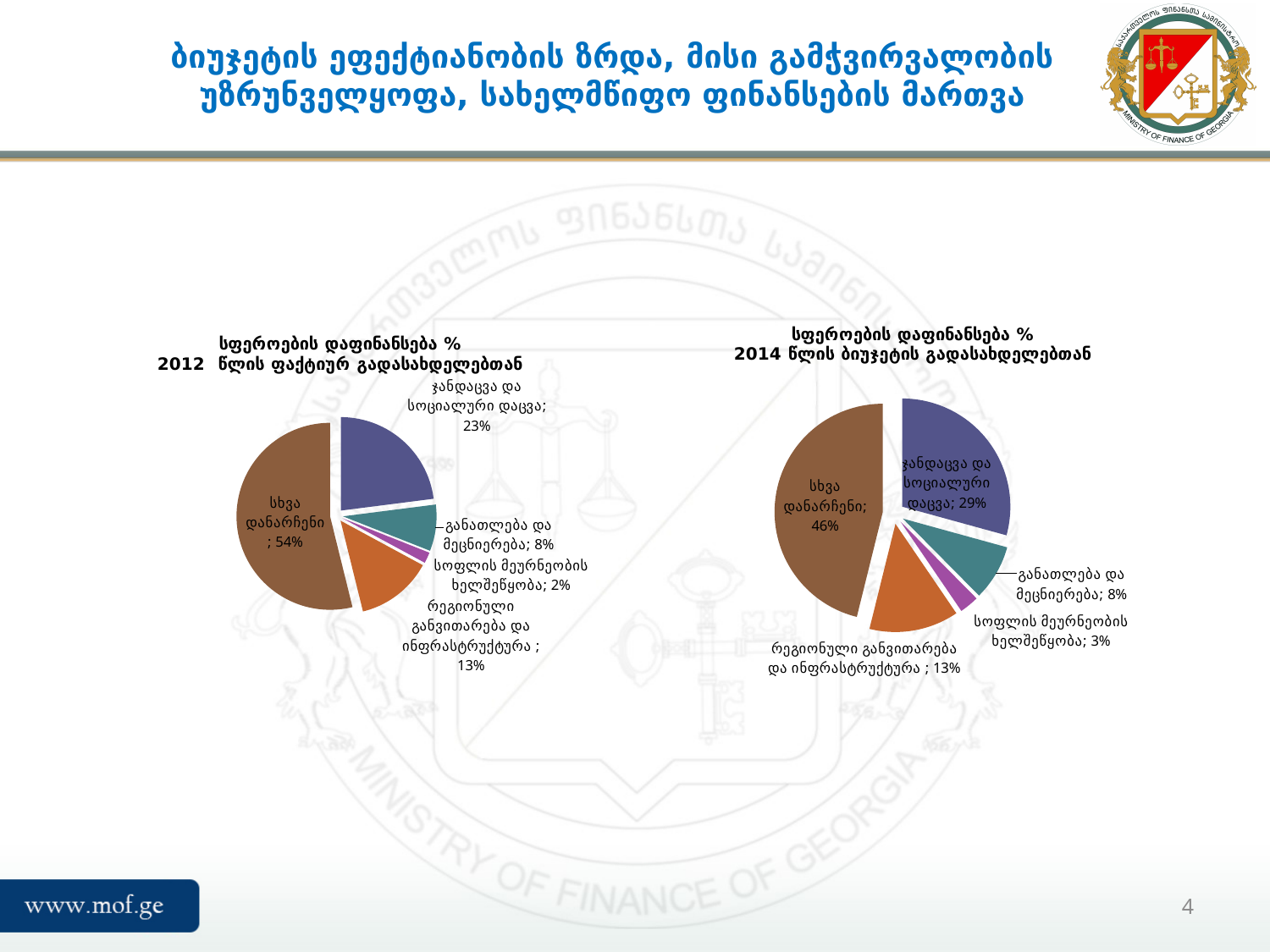
In the left chart (2012), which category has the largest slice? სხვა დანარჩენი What is the difference between the share for სხვა დანარჩენი in the left chart (2012) and in the right chart (2014)? 8% How many slices does the right chart (2014) have? 5 In the right chart (2014), which category has the smallest slice? სოფლის მეურნეობის ხელშეწყობა In the left chart (2012), what share is labelled for სხვა დანარჩენი? 54% In the left chart (2012), what is the difference between the shares for რეგიონული განვითარება და ინფრასტრუქტურა and განათლება და მეცნიერება? 5% In the right chart (2014), what share is labelled for სოფლის მეურნეობის ხელშეწყობა? 3% What kind of chart is the left chart (2012)? pie chart Which is larger: the share for ჯანდაცვა და სოციალური დაცვა in the left chart (2012) or in the right chart (2014)? 2014 (29%) In the left chart (2012), what share is labelled for ჯანდაცვა და სოციალური დაცვა? 23% In the right chart (2014), what share is labelled for ჯანდაცვა და სოციალური დაცვა? 29% How many pie charts are shown on the slide? 2